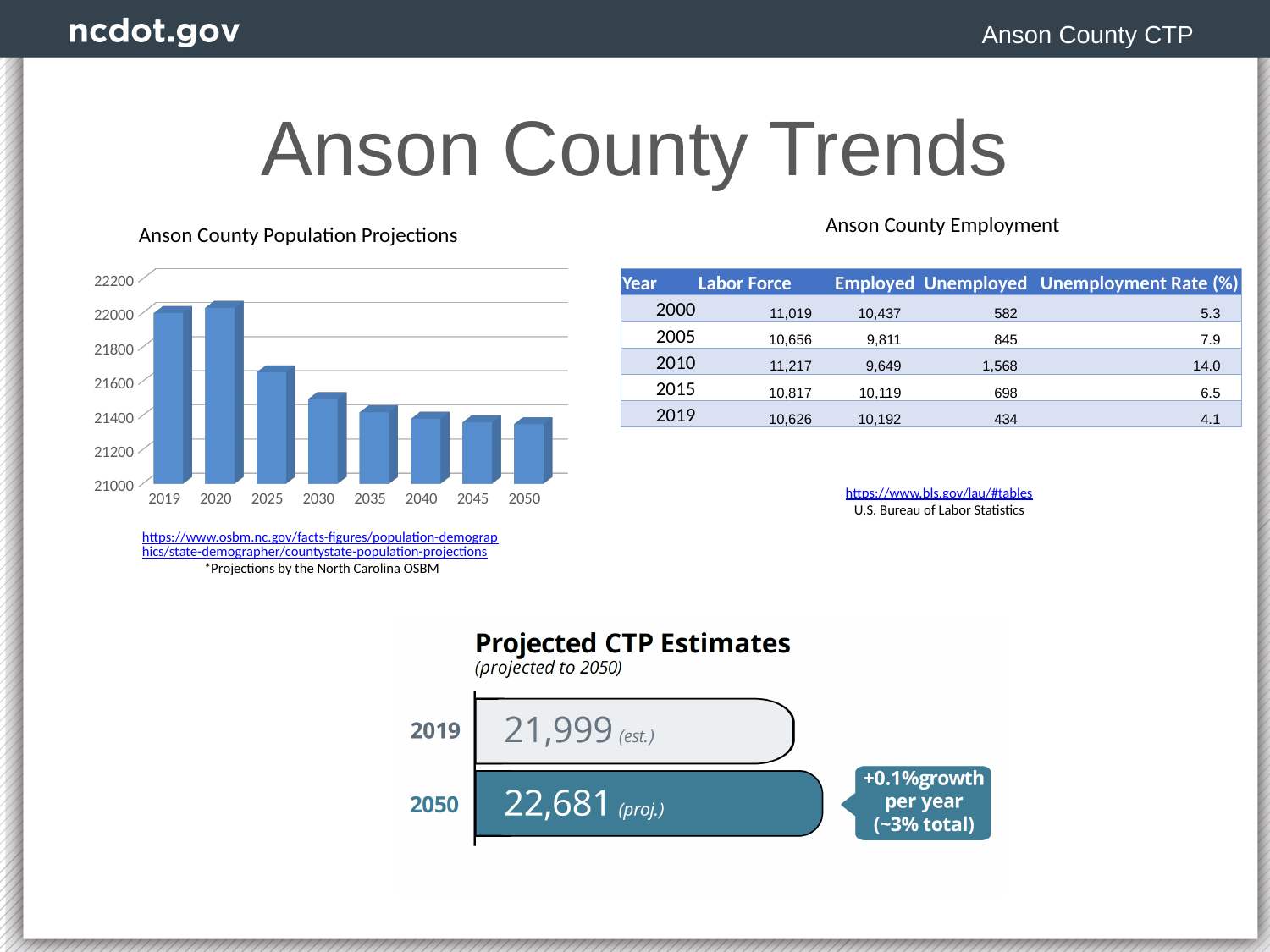
In the Anson County Population Projections chart, is the value for 2050 greater or less than 21600? less What kind of chart is the Anson County Population Projections chart? bar chart In the Anson County Population Projections chart, do the values generally rise or fall from 2020 to 2050? fall Which year has the highest bar in the Anson County Population Projections chart? 2020 In the Anson County Population Projections chart, is the value for 2030 greater or less than 21400? greater What is the lowest value shown on the vertical axis of the Anson County Population Projections chart? 21000 In the Anson County Population Projections chart, which is larger, the value for 2025 or the value for 2035? 2025 In the Anson County Population Projections chart, which is larger, the value for 2019 or the value for 2050? 2019 In the Anson County Population Projections chart, is the value for 2019 greater or less than 21800? greater What is the title of the bar chart on the slide? Anson County Population Projections How many years are shown on the x axis of the Anson County Population Projections chart? 8